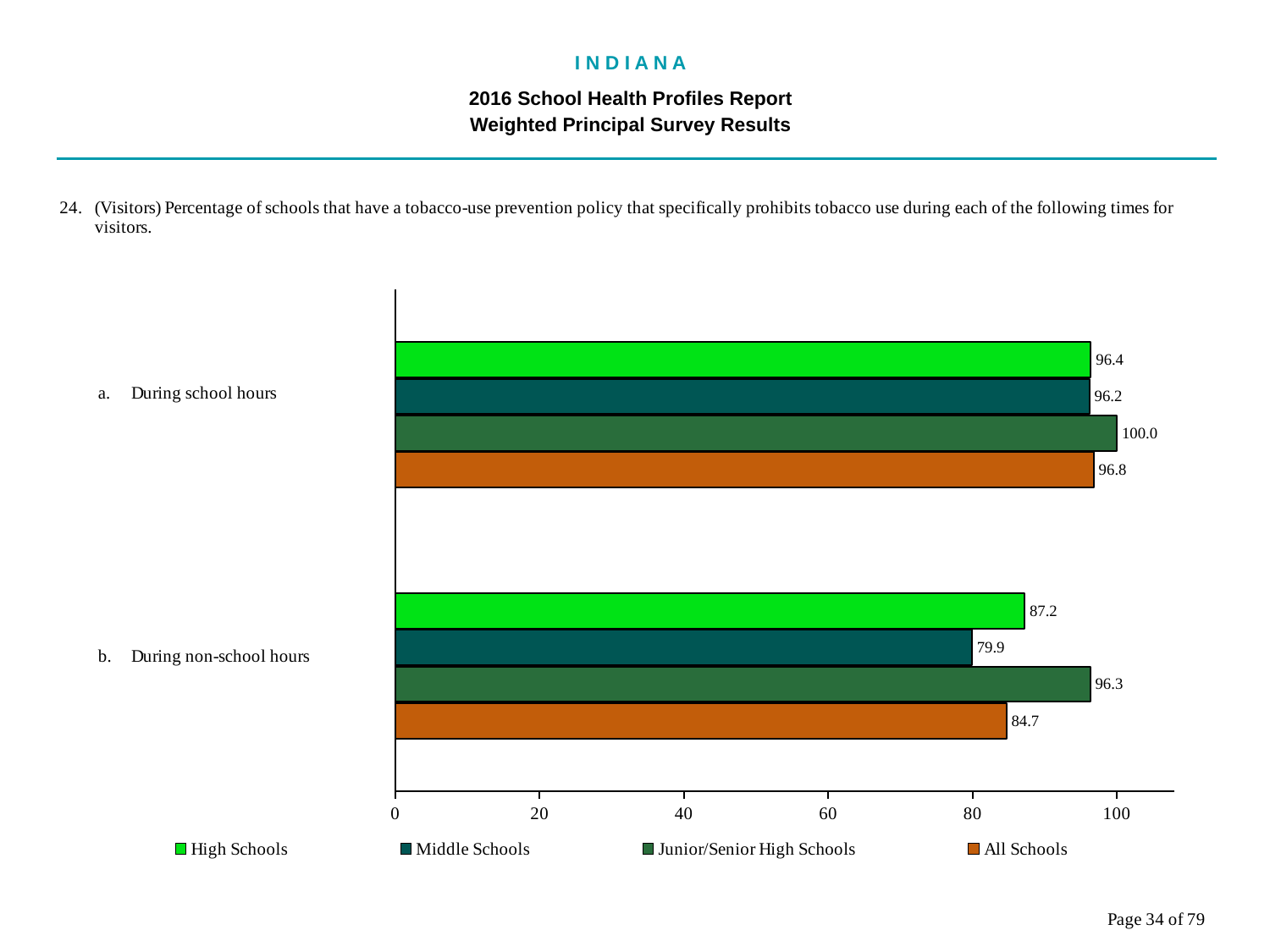
What kind of chart is shown on the slide? bar chart What is the difference between the High Schools values for school hours and non-school hours? 9.2 Which is larger: the Middle Schools value during non-school hours or the All Schools value during non-school hours? All Schools What is the value for High Schools during school hours? 96.4 What colour represents All Schools in the legend? orange What is the value for All Schools during non-school hours? 84.7 How many series does the legend list? 4 Which school type has the highest value during non-school hours? Junior/Senior High Schools Which school type has the lowest value during non-school hours? Middle Schools Is the value for Middle Schools during non-school hours greater or less than 80? less What is the value for Junior/Senior High Schools during school hours? 100.0 What is the value for Middle Schools during non-school hours? 79.9